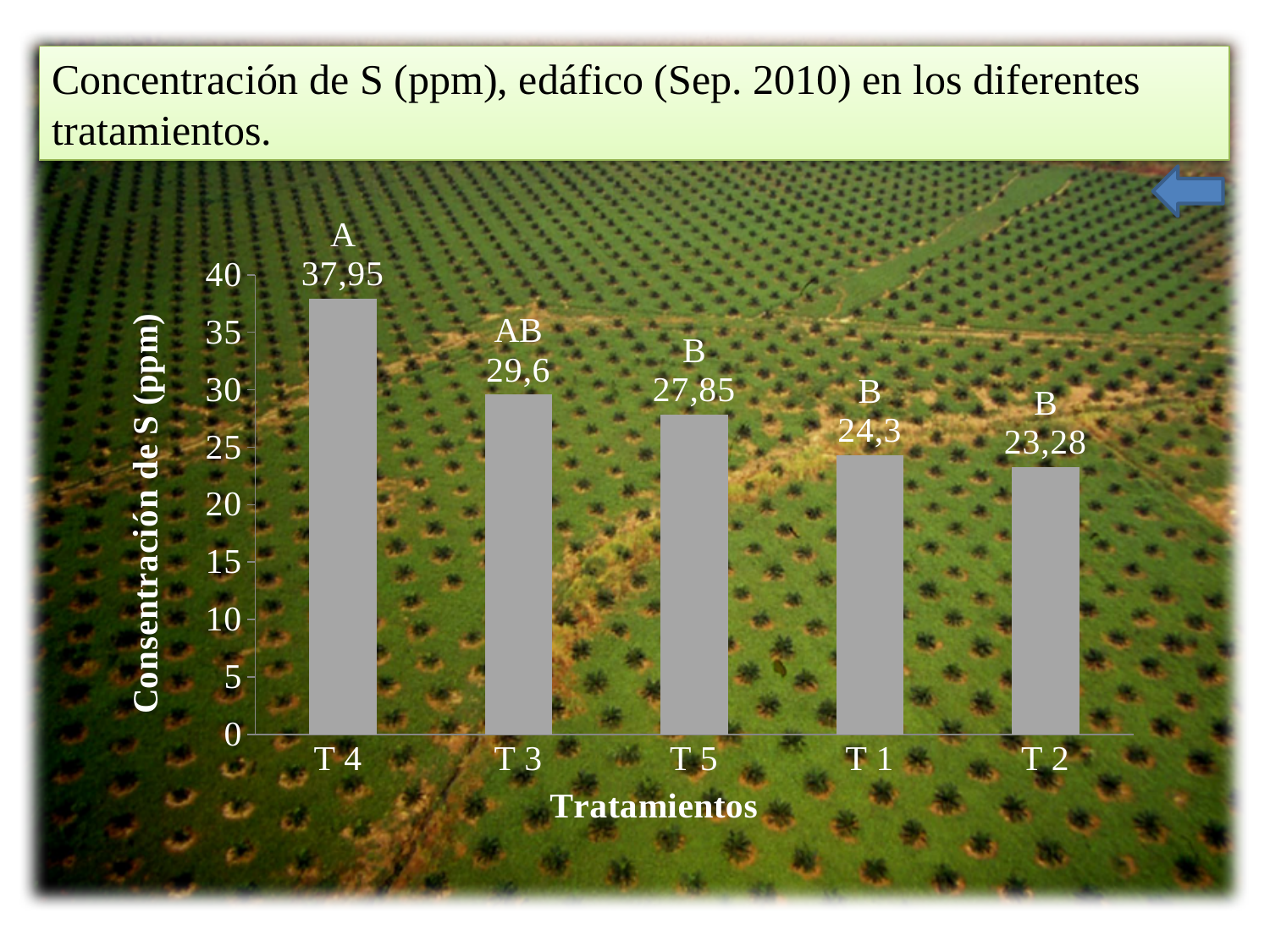
Which treatment has the highest S concentration? T 4 Which treatment has a larger S concentration, T 5 or T 1? T 5 Which treatment has the lowest S concentration? T 2 What is the S concentration value for treatment T 4? 37,95 What is the difference between the S concentration values for T 1 and T 2? 1,02 What is the S concentration value for treatment T 3? 29,6 What is the difference between the S concentration values for T 4 and T 3? 8,35 How many treatments are shown on the x axis? 5 What is the S concentration value for treatment T 2? 23,28 Is the value for T 3 greater or less than 25? greater What kind of chart is shown on the slide? bar chart What statistical group letter is shown above the bar for T 3? AB